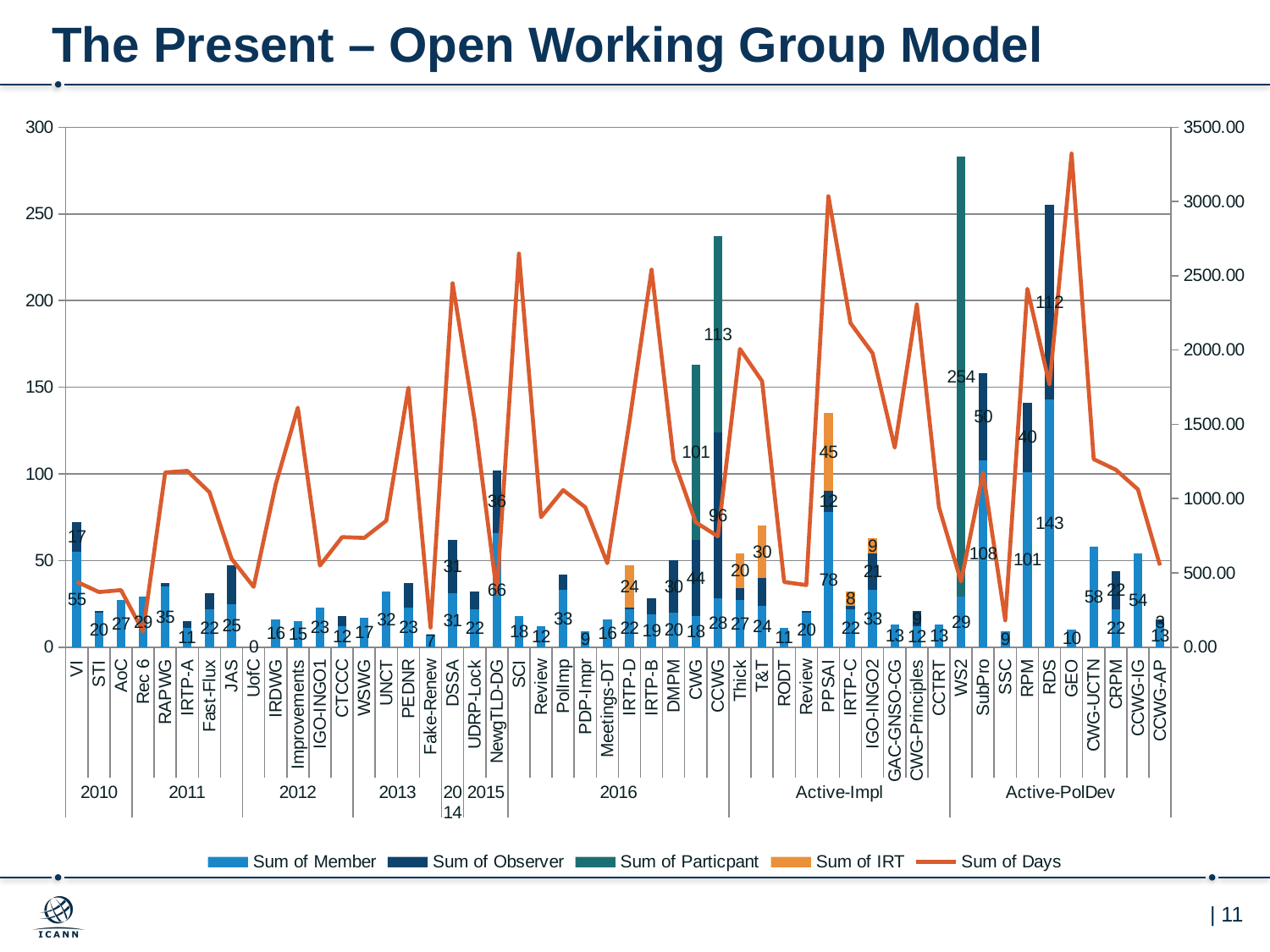
What is the total of the stacked bar for RDS (Member and Observer)? 255 What kind of chart is shown on the slide? A stacked bar chart combined with a line chart What is the Sum of Particpant value for WS2? 254 Which has the larger Sum of Member value, RDS or RPM? RDS What is the Sum of Member value for RDS? 143 How many series does the legend list? 5 What is the total of the stacked bar for CCWG (Member, Observer and Particpant)? 237 Which category has the tallest stacked bar? WS2 What is the Sum of Observer value for SubPro? 50 Is the Sum of Days value for GEO greater or less than 3000.00? greater What is the Sum of IRT value for PPSAI? 45 What is the difference between the Sum of Member for RDS and the Sum of Member for SubPro? 35